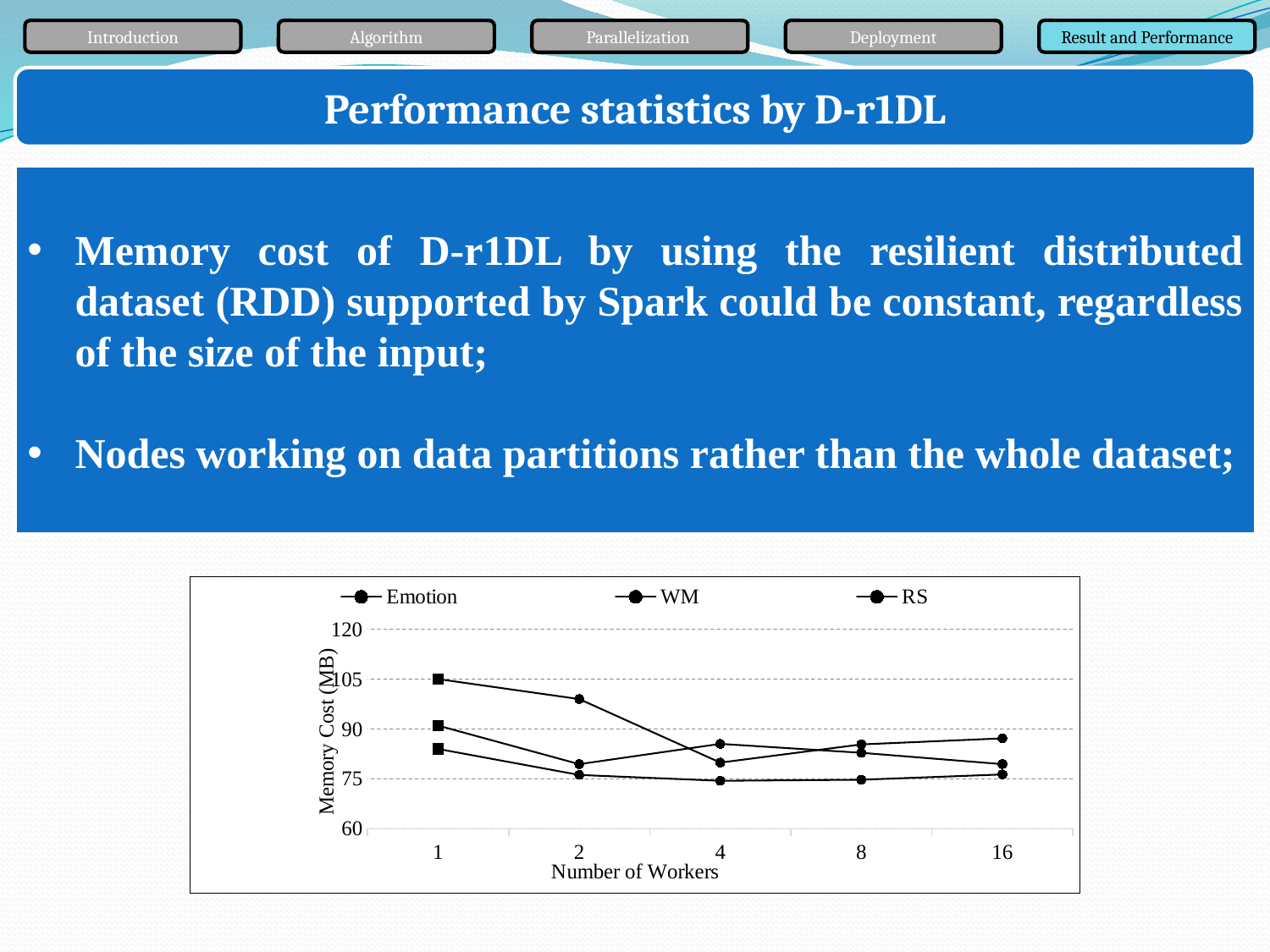
What kind of chart is shown on the slide? line chart Is the highest value plotted at 2 workers larger or smaller than the highest value plotted at 1 worker? smaller Is the lowest value plotted at 4 workers greater or less than 90? less What is the label of the x axis of the chart? Number of Workers What is the label of the y axis of the chart? Memory Cost (MB) How many series does the chart's legend list? 3 Is the highest value plotted at 16 workers greater or less than 105? less At which number of workers is the highest memory cost on the chart plotted? 1 Is the highest value plotted at 1 worker greater or less than 90? greater Overall, do the memory cost values rise or fall as the number of workers increases from 1 to 16? fall How many points are marked along the x axis (Number of Workers) of the chart? 5